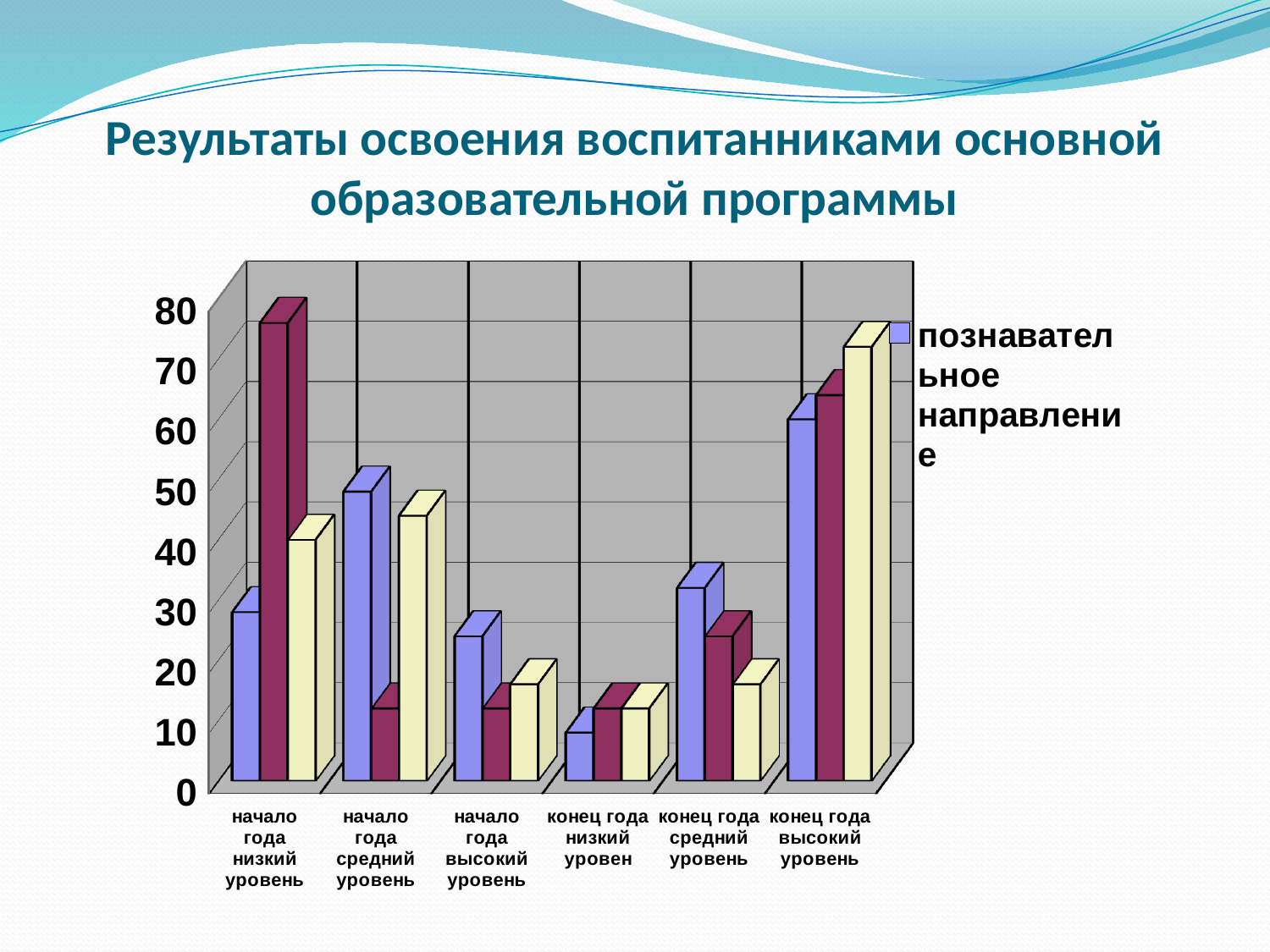
Which series name is readable in the chart legend? познавательное направление What kind of chart is shown on the slide? bar chart Is the value of the blue bar (познавательное направление) for 'начало года средний уровень' greater or less than 40? greater How many categories are shown on the x axis of the chart? 6 What is the title of the slide containing the chart? Результаты освоения воспитанниками основной образовательной программы Is the value of the maroon bar for 'начало года низкий уровень' greater or less than 70? greater In which category is the blue bar (познавательное направление) the shortest? конец года низкий уровен In which category is the maroon bar the tallest? начало года низкий уровень How many bars are plotted for each category in the chart? 3 Is the value of the yellow bar for 'конец года высокий уровень' greater or less than 60? greater Which is larger: the maroon bar for 'начало года низкий уровень' or the maroon bar for 'конец года высокий уровень'? начало года низкий уровень